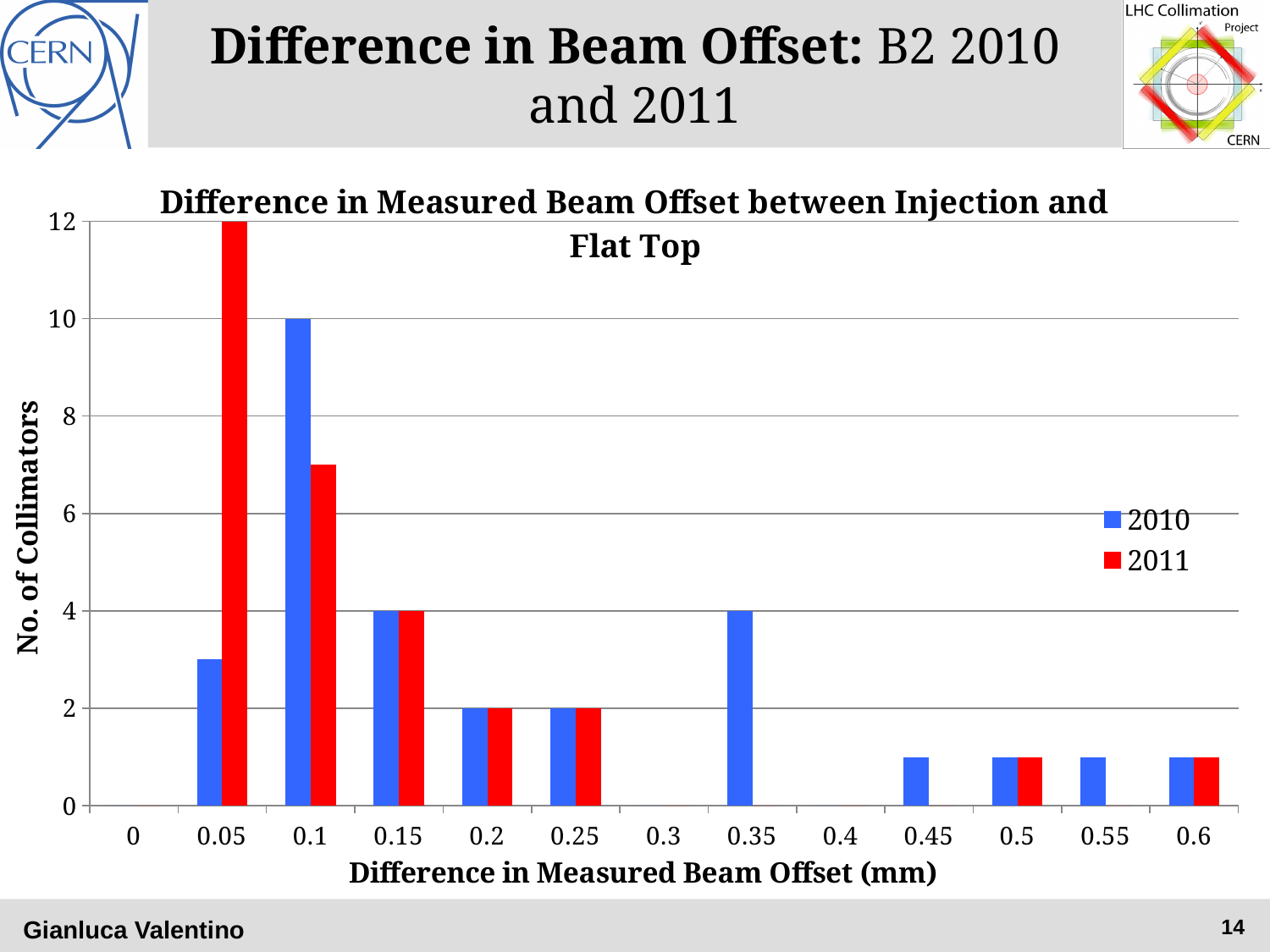
What is the difference between the 2011 value at 0.05 mm and the 2010 value at 0.1 mm? 2 At a difference of 0.05 mm, which series has the larger value, 2010 or 2011? 2011 At which difference value does the 2011 series reach its highest number of collimators? 0.05 Is the value for 2011 at 0.1 mm greater or less than 8? less At which difference value does the 2010 series reach its highest number of collimators? 0.1 Is the value for 2010 at 0.05 mm greater or less than 4? less What is the number of collimators for 2011 at a difference of 0.05 mm? 12 What kind of chart is shown on the slide? Bar chart How many series does the legend list? 2 What is the number of collimators for 2010 at a difference of 0.35 mm? 4 How many categories are shown along the x axis? 13 What is the number of collimators for 2010 at a difference of 0.1 mm? 10